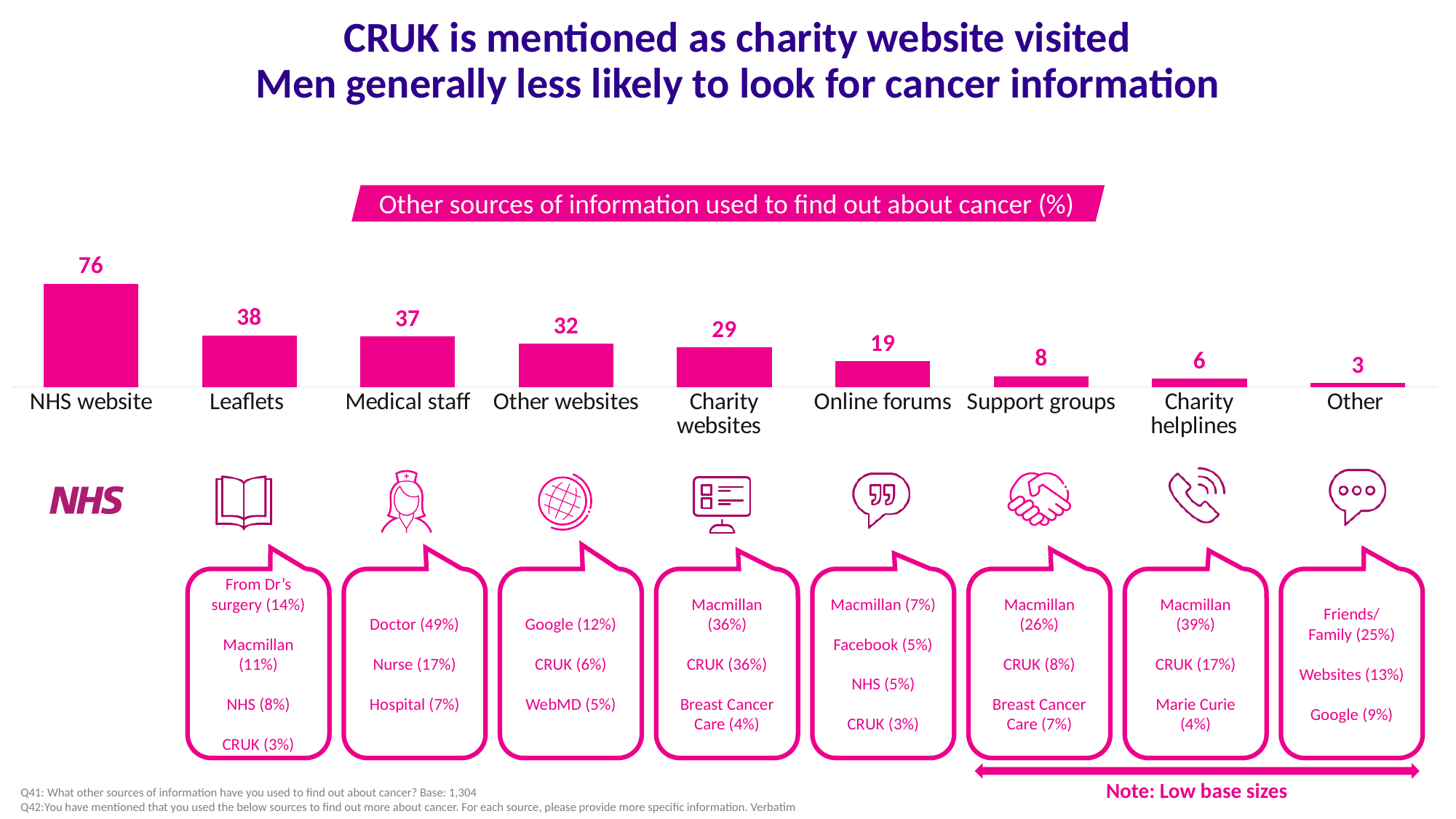
Do the bar values rise or fall from left to right across the chart? Fall What is the value for NHS website? 76 What is the difference between the values for Support groups and Charity helplines? 2 Which source has the highest value? NHS website How many sources of information are shown as bars in the chart? 9 Which source has the lowest value? Other What is the difference between the values for NHS website and Leaflets? 38 What is the title of the chart? Other sources of information used to find out about cancer (%) What is the value for Online forums? 19 What kind of chart is shown on the slide? Bar chart What is the value for Charity websites? 29 Which is larger, the value for Other websites or the value for Charity websites? Other websites